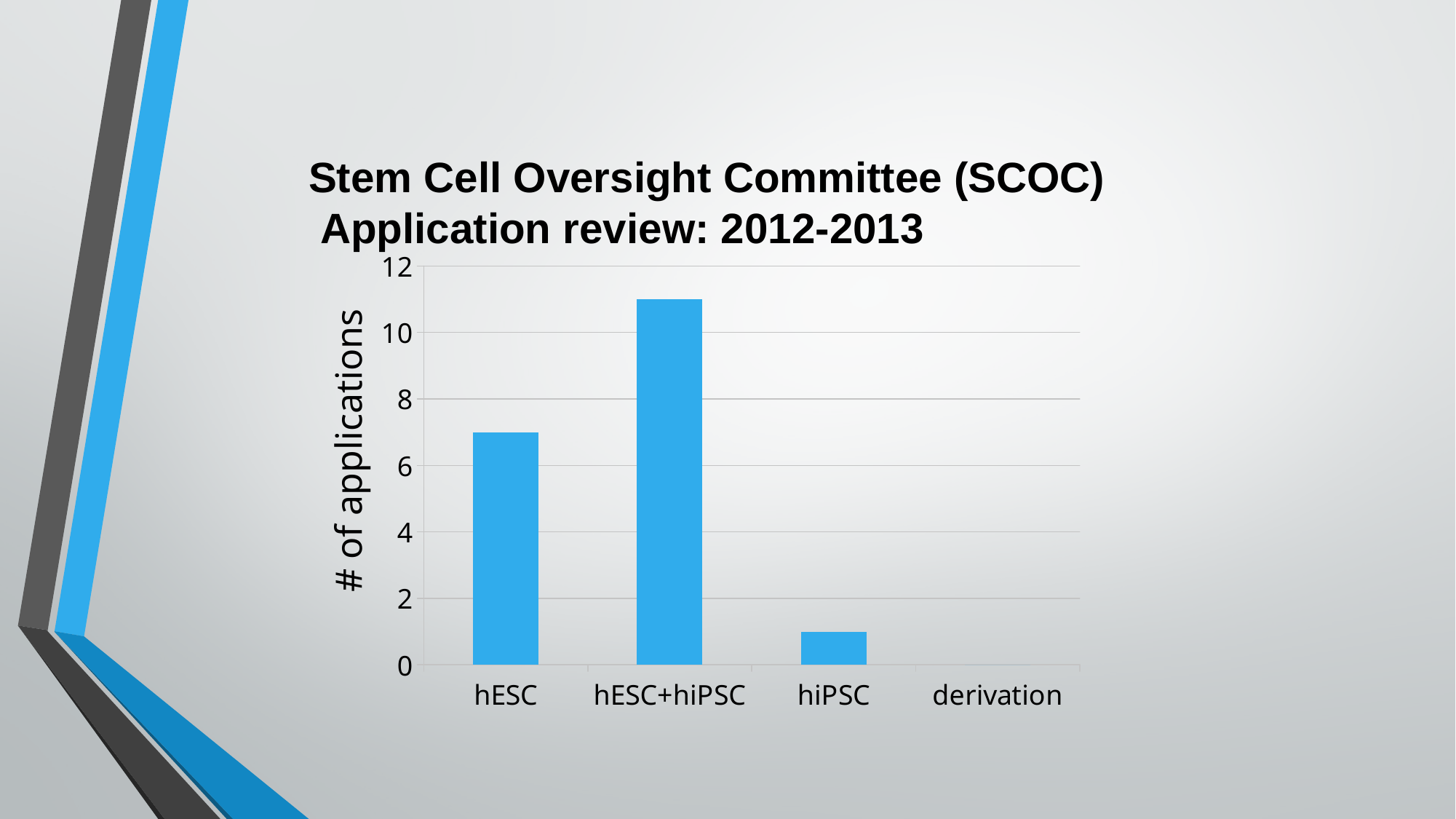
What is the label of the vertical axis of the chart? # of applications Is the value for hESC+hiPSC greater or less than 10? greater What kind of chart is shown on the slide? bar chart How many categories are shown on the x axis of the chart? 4 Is the value for hESC greater or less than 6? greater Which has more applications, hESC or hiPSC? hESC Which category has the lowest number of applications? derivation Is the value for hESC greater or less than 8? less Which category has the highest number of applications? hESC+hiPSC What is the title of the chart? Stem Cell Oversight Committee (SCOC) Application review: 2012-2013 Which has more applications, hESC+hiPSC or hESC? hESC+hiPSC